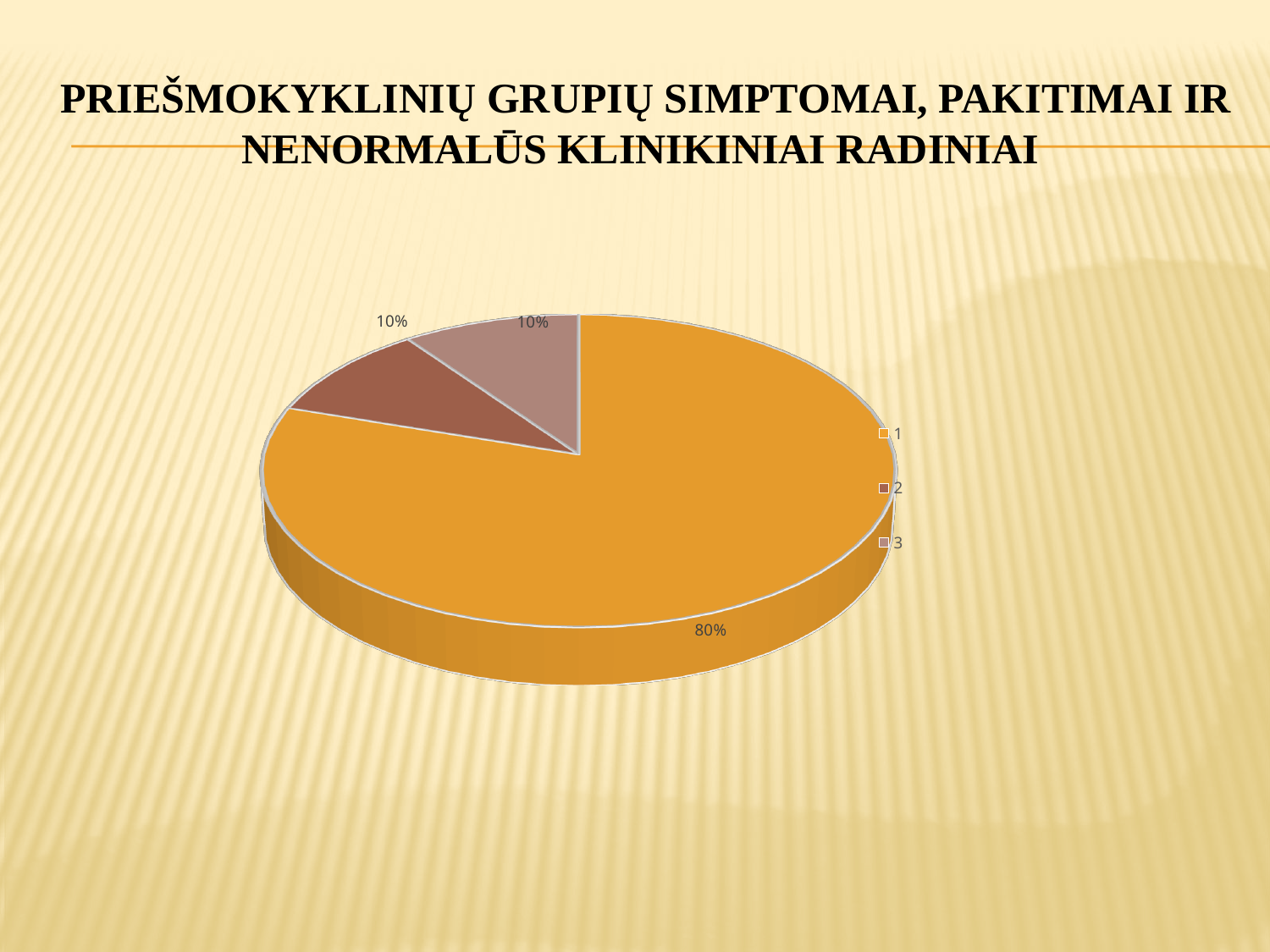
What share of the pie does category 2 have? 10% Which category has the largest slice of the pie? 1 What is the difference between the share of category 1 and the share of category 2? 70 percentage points What is the smallest percentage shown on the pie chart? 10% What labels are listed in the legend? 1, 2, 3 How many entries does the legend list? 3 What share of the pie does category 1 have? 80% What colour is the largest slice of the pie? orange How many slices does the pie chart have? 3 What kind of chart is shown on the slide? pie chart What share of the pie does category 3 have? 10% Which is larger, the share of category 1 or the share of category 3? category 1